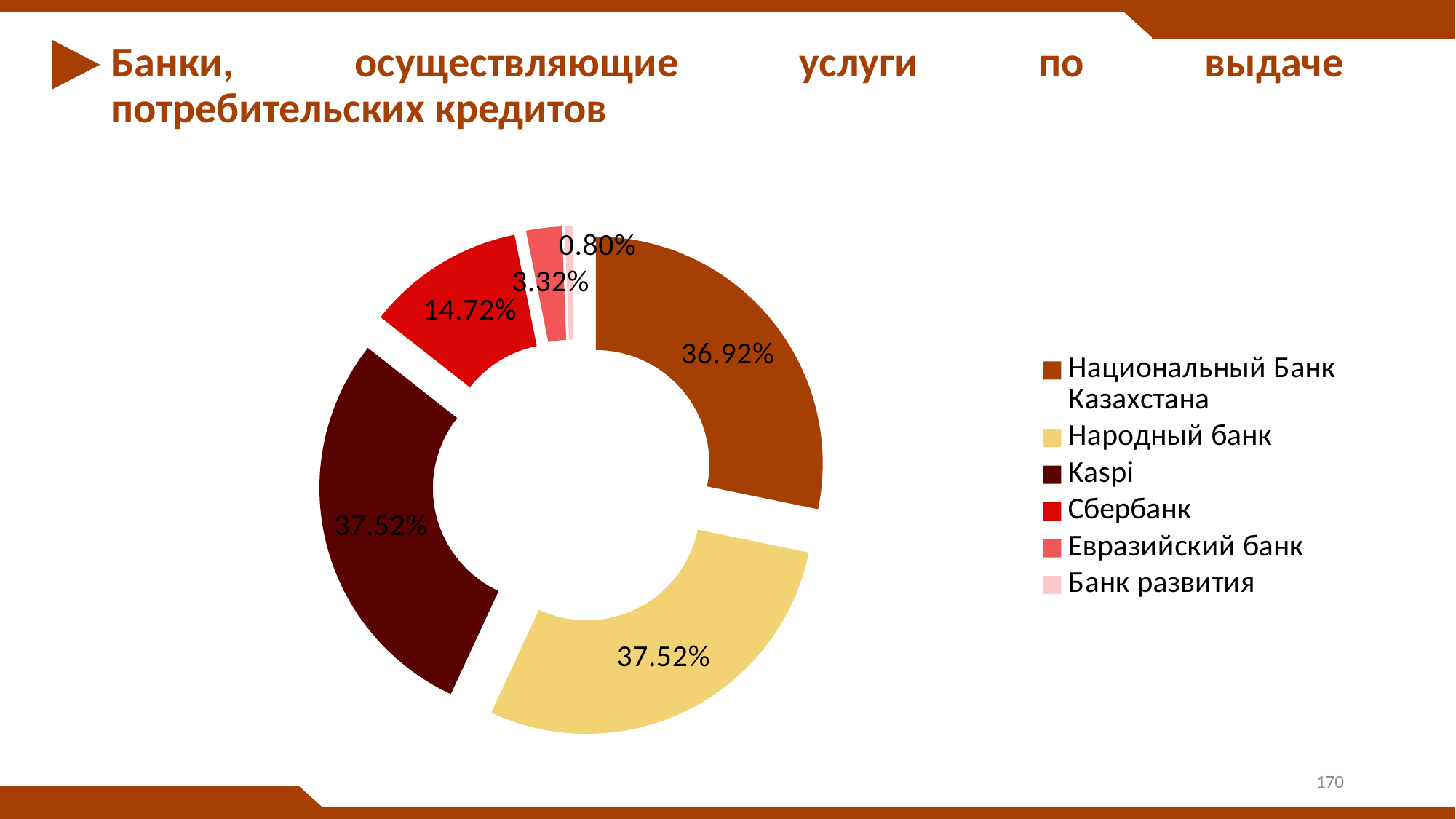
What kind of chart is shown on the slide? doughnut (pie) chart What percentage is shown for Сбербанк? 14.72% What is the difference between the values for Народный банк and Национальный Банк Казахстана? 0.60% What percentage is shown for Национальный Банк Казахстана? 36.92% Which legend entry is shown with a dark red (maroon) colour? Kaspi What is the share of the pie for Банк развития? 0.80% Which is larger, the slice for Национальный Банк Казахстана or the slice for Сбербанк? Национальный Банк Казахстана What percentage is shown for Kaspi? 37.52% How many categories (banks) are shown in the chart? 6 What is the difference between the values for Сбербанк and Евразийский банк? 11.40% What percentage is shown for Евразийский банк? 3.32% Which bank has the smallest slice in the chart? Банк развития